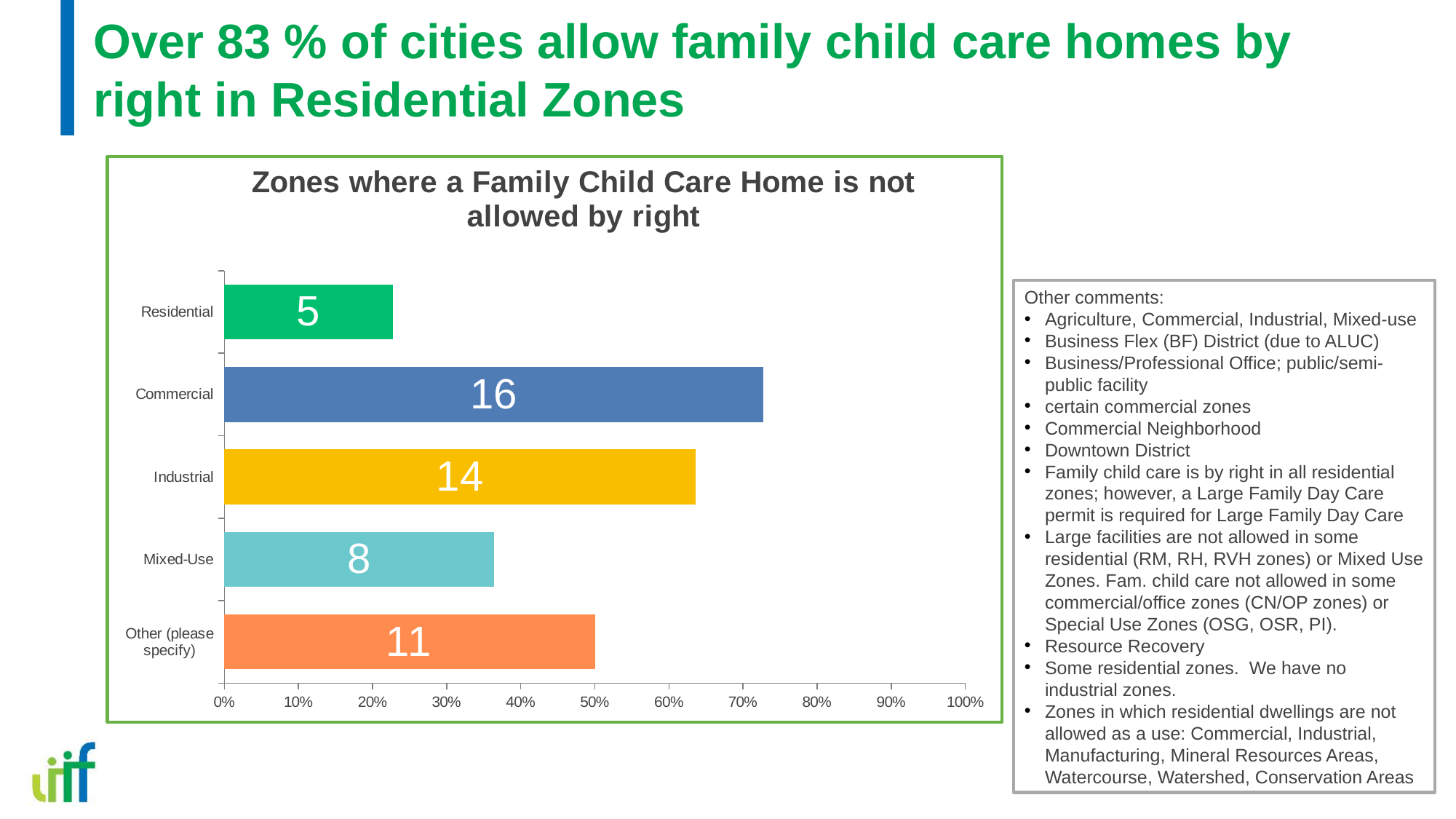
Which zone has the highest value in the chart? Commercial What is the data label shown on the Other (please specify) bar? 11 What is the difference between the data labels for Commercial and Industrial? 2 What type of chart is shown on the slide? Bar chart What is the data label shown on the Commercial bar? 16 Which zone has the lowest value in the chart? Residential What is the data label shown on the Residential bar? 5 How many zone categories are shown in the chart? 5 What is the data label shown on the Industrial bar? 14 Is the Commercial bar greater or less than 70% on the axis? greater Which has a larger value, Mixed-Use or Other (please specify)? Other (please specify) What is the data label shown on the Mixed-Use bar? 8